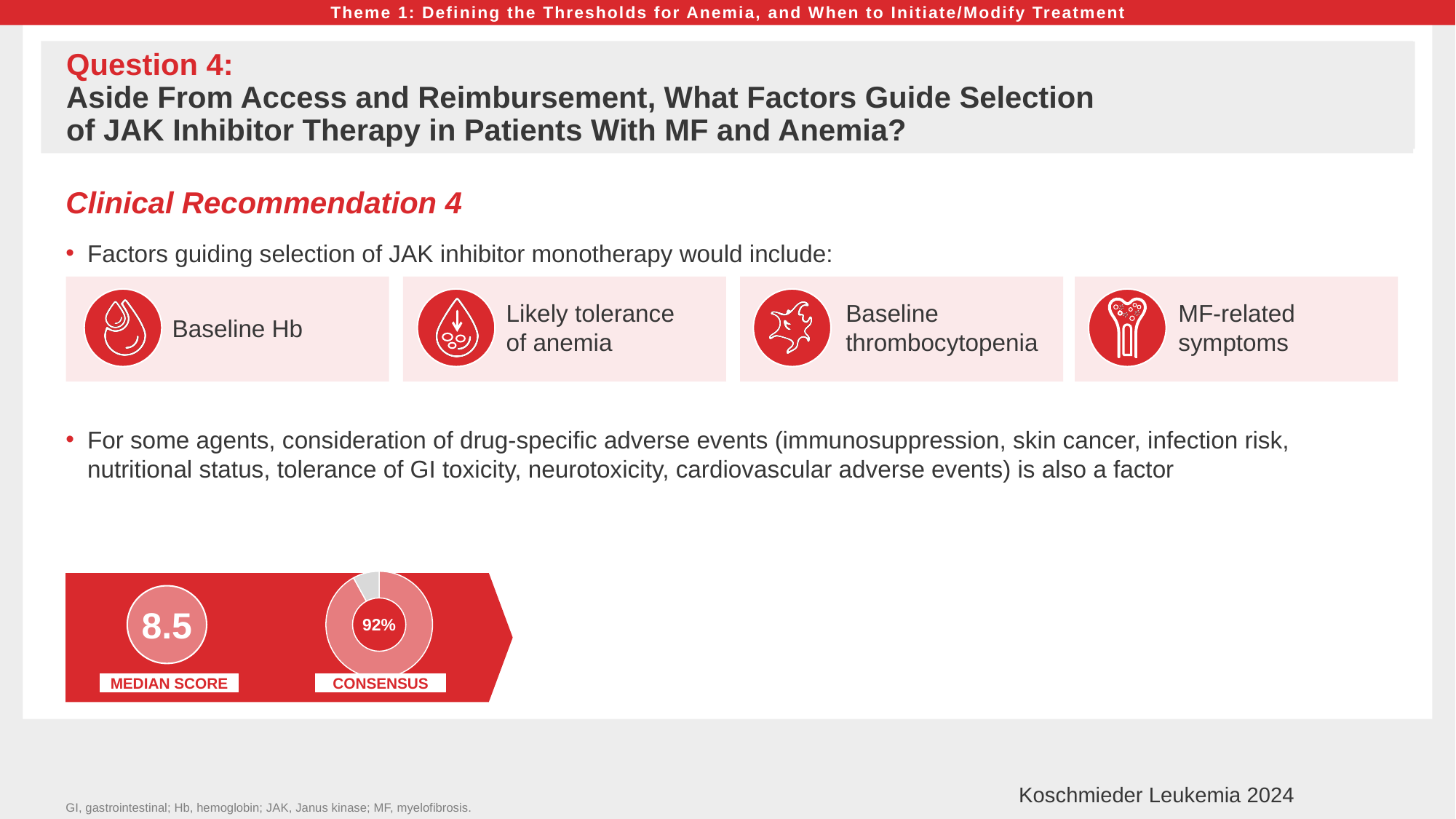
What share of the donut chart is filled by the consensus slice? 92% What median score is shown next to the consensus donut chart? 8.5 What label appears beneath the 8.5 value to the left of the donut chart? MEDIAN SCORE What consensus percentage is shown in the donut chart? 92% What label appears beneath the donut chart? CONSENSUS What share of the donut chart is not covered by the 92% consensus slice? 8% Which slice of the donut chart is larger, the red/pink consensus slice or the grey slice? The red/pink consensus slice How many slices does the consensus donut chart have? 2 Is the consensus value shown in the donut chart greater or less than 50%? greater What kind of chart is used to display the consensus value? Donut (pie) chart